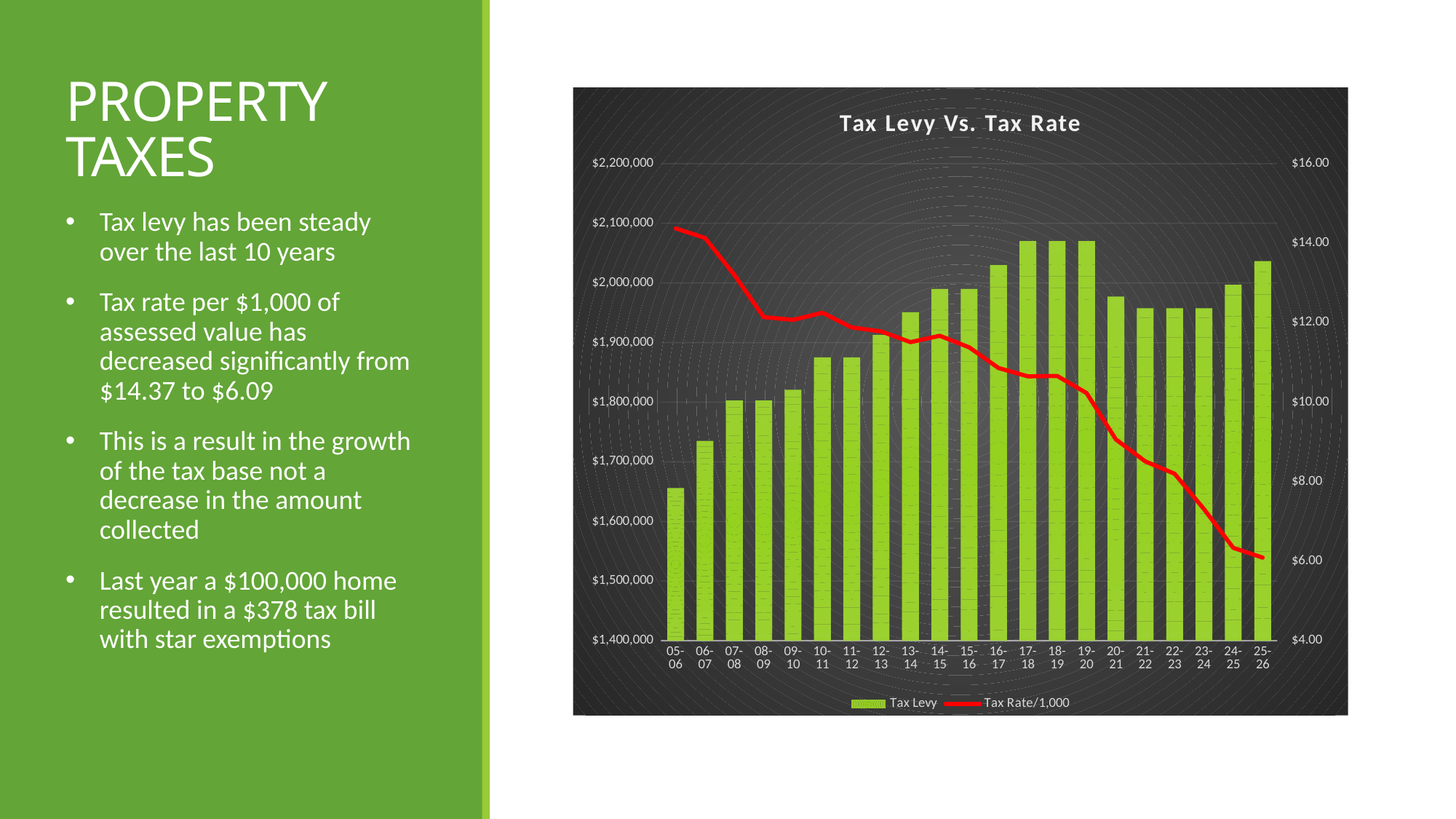
Which year has the larger Tax Levy, 24-25 or 25-26? 25-26 Is the Tax Levy for 05-06 greater or less than $1,700,000? less What is the title of the chart? Tax Levy Vs. Tax Rate How many series does the chart legend list? 2 How many fiscal years are shown on the x axis? 21 Is the Tax Rate/1,000 for 25-26 greater or less than $8.00? less Is the Tax Levy for 10-11 greater or less than $1,900,000? less What kind of chart is shown on the slide? A combination bar and line chart Which year has the lowest Tax Levy bar? 05-06 Does the Tax Rate/1,000 line rise or fall from 05-06 to 25-26? Fall What are the two series named in the legend? Tax Levy and Tax Rate/1,000